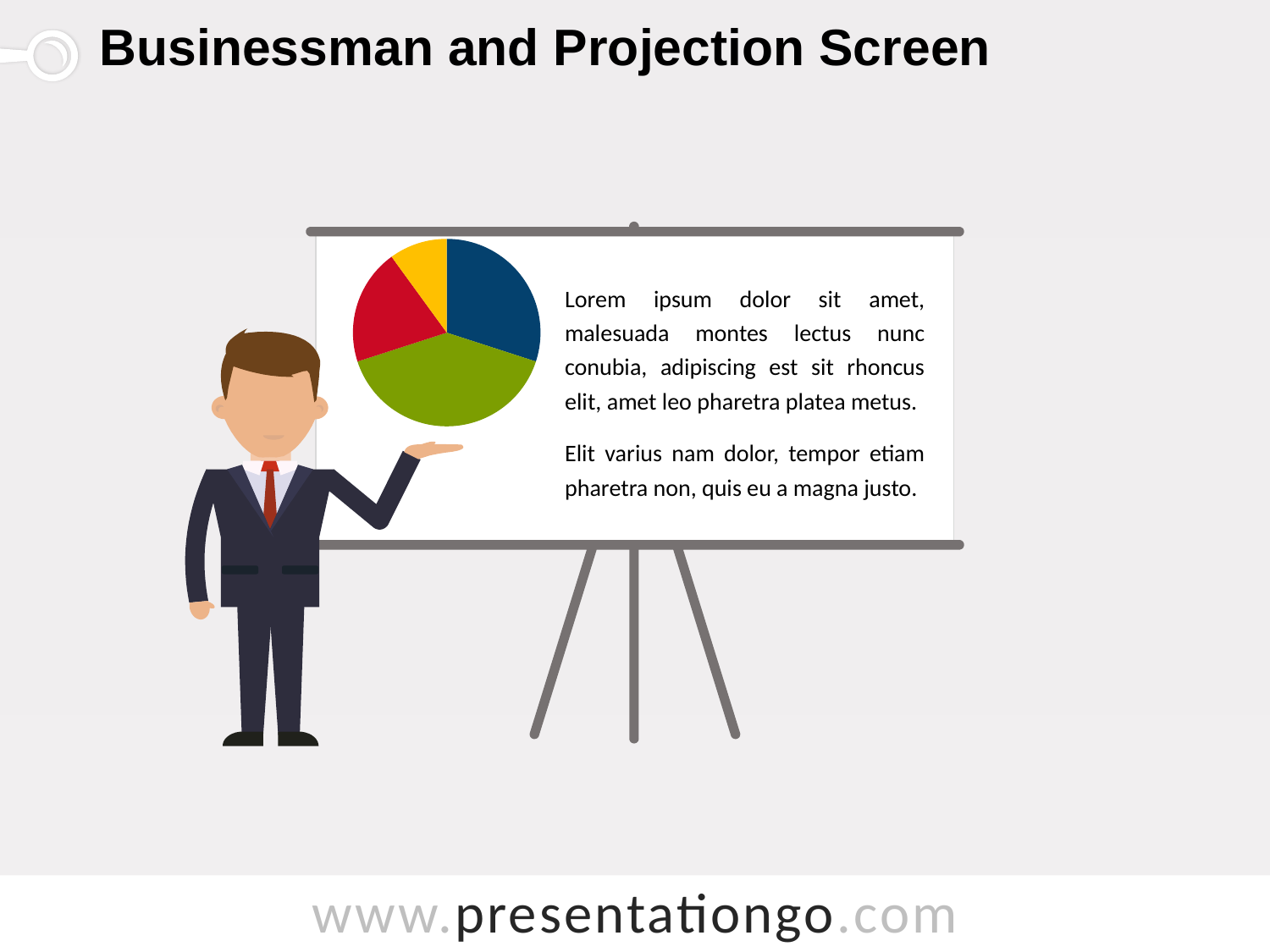
In the pie chart, which slice is larger, the green one or the yellow one? green How many slices does the pie chart on the projection screen have? 4 In the pie chart, which slice is larger, the blue one or the red one? blue Does the pie chart display a legend? No Which colour slice is the smallest in the pie chart? yellow What kind of chart is shown on the projection screen? pie chart Does the pie chart show any data labels or percentages on its slices? No Which colour slice is the largest in the pie chart? green